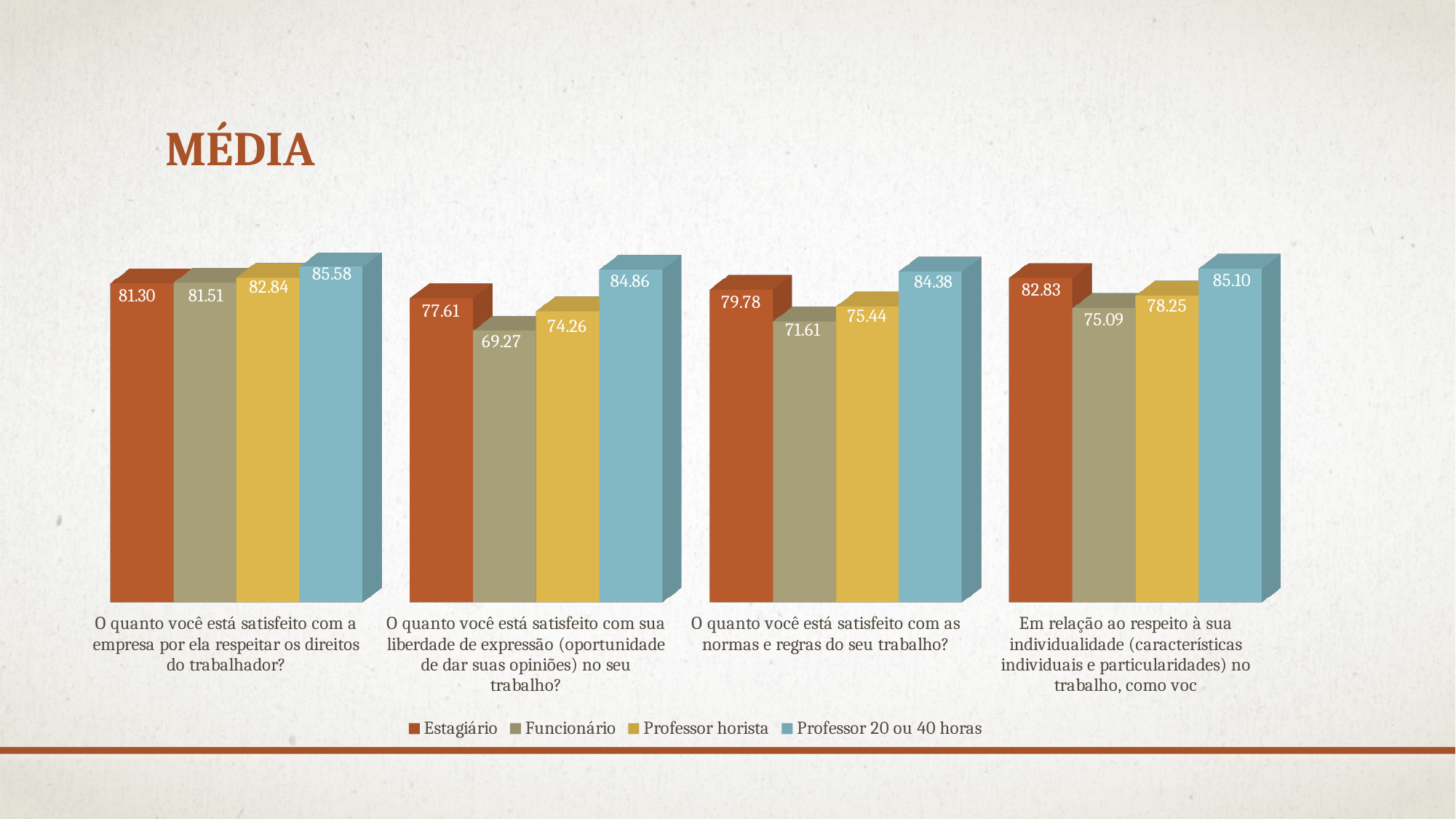
What is the value for Estagiário on the question about satisfaction with the company respecting workers' rights (first category)? 81.30 Which is larger on the question about respect for individuality (fourth category): Estagiário or Professor horista? Estagiário What is the difference between Professor 20 ou 40 horas and Funcionário on the question about freedom of expression (second category)? 15.59 Which series has the highest value on the question about freedom of expression (second category)? Professor 20 ou 40 horas How many question categories are shown on the x axis? 4 Which series has the lowest value on the question about norms and rules of work (third category)? Funcionário What is the value for Professor 20 ou 40 horas on the question about respect for individuality (fourth category)? 85.10 What kind of chart is shown on the slide? Bar chart How many series does the legend list? 4 What is the title of the slide? MÉDIA What is the value for Professor horista on the question about norms and rules of work (third category)? 75.44 What is the value for Funcionário on the question about freedom of expression (second category)? 69.27